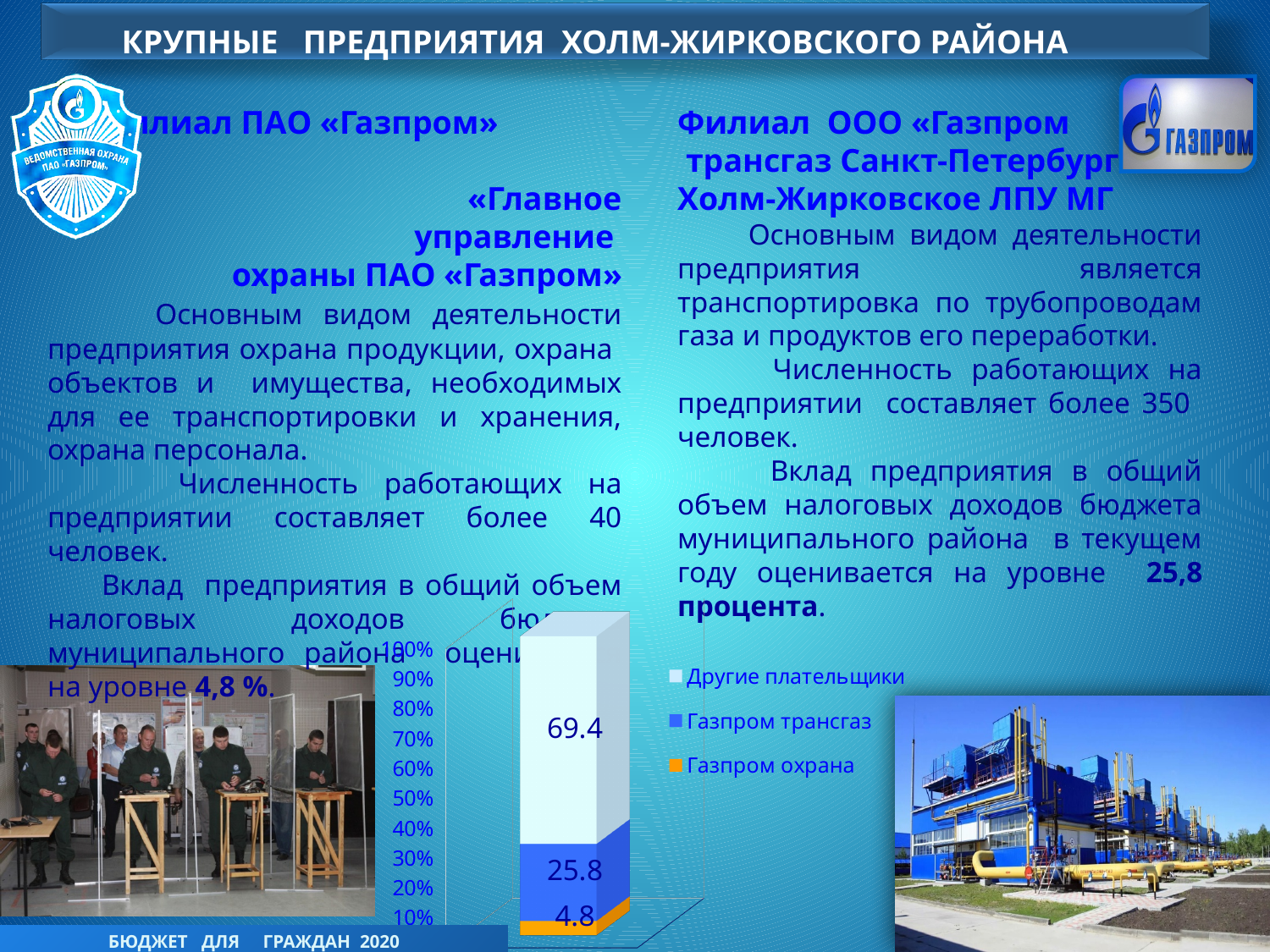
What is the total of the three segments in the stacked bar? 100.0 What value is shown for the Газпром охрана segment of the stacked bar? 4.8 What value is shown for the Газпром трансгаз segment of the stacked bar? 25.8 What kind of chart is shown on the slide? Stacked bar chart What is the highest tick label shown on the chart's vertical axis? 100% What is the difference between the Другие плательщики value and the Газпром трансгаз value? 43.6 Which series has the largest segment in the stacked bar? Другие плательщики Which series has the smallest segment in the stacked bar? Газпром охрана Which is larger, the Газпром трансгаз segment or the Газпром охрана segment? Газпром трансгаз How many series does the chart legend list? 3 What value is shown for the Другие плательщики segment of the stacked bar? 69.4 What is the difference between the Газпром трансгаз value and the Газпром охрана value? 21.0